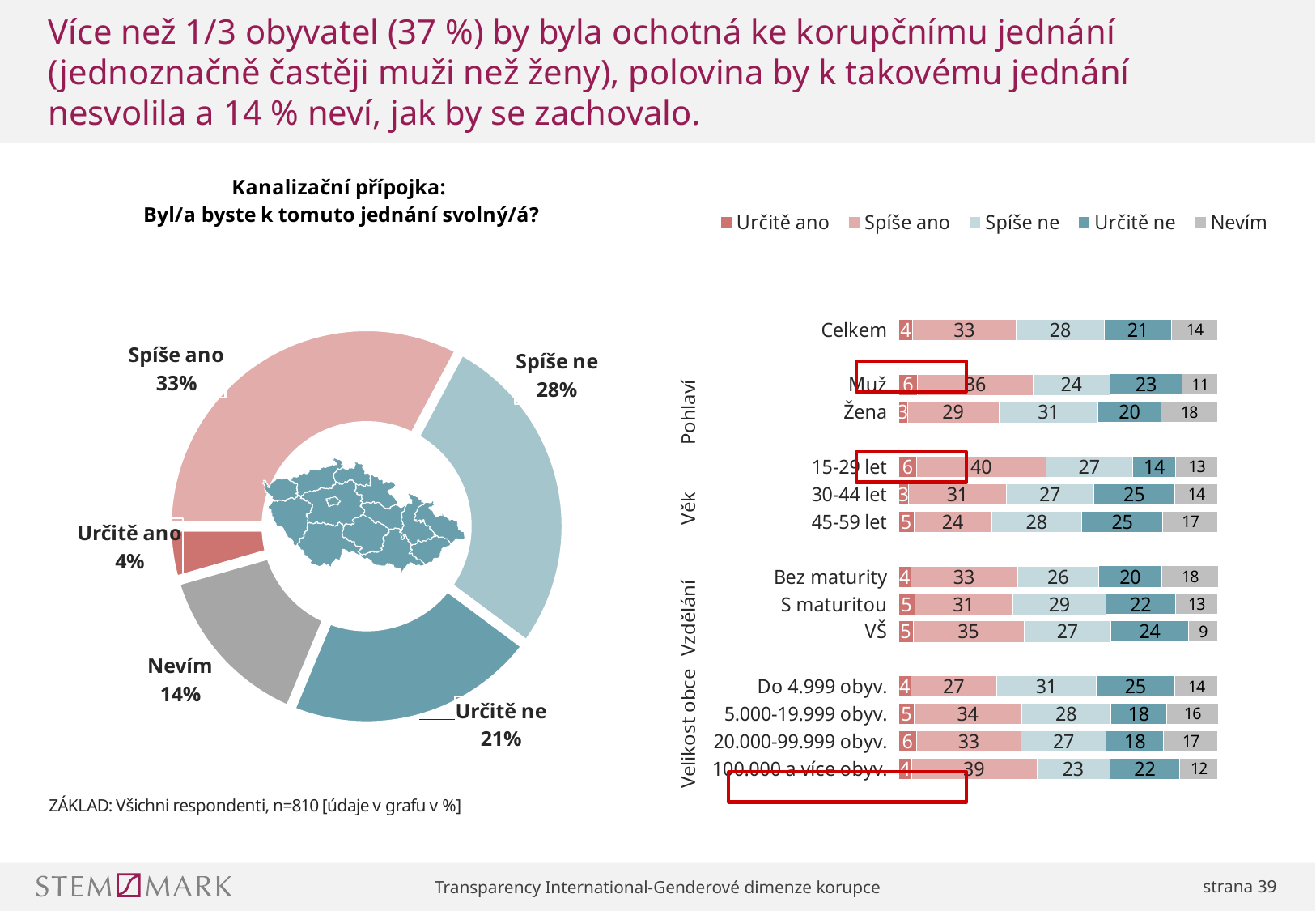
In the stacked bar chart on the right, which has the higher "Nevím" value: "Bez maturity" or "S maturitou"? Bez maturity In the stacked bar chart on the right, what is the "Určitě ne" value for "Žena"? 20 In the stacked bar chart on the right, what is the "Nevím" value for "VŠ"? 9 In the donut chart on the left, what percentage of respondents answered "Spíše ano"? 33% In the donut chart on the left, which answer has the smallest share? Určitě ano In the stacked bar chart on the right, what is the total of the "Celkem" bar? 100 In the stacked bar chart on the right, what is the difference between the "Spíše ne" values for "Žena" and "Muž"? 7 What kind of chart is shown on the right side of the slide? Stacked bar chart In the donut chart on the left, which answer has the largest share? Spíše ano In the stacked bar chart on the right, what is the "Spíše ano" value for "15-29 let"? 40 How many series does the legend of the stacked bar chart on the right list? 5 How many slices does the donut chart on the left have? 5